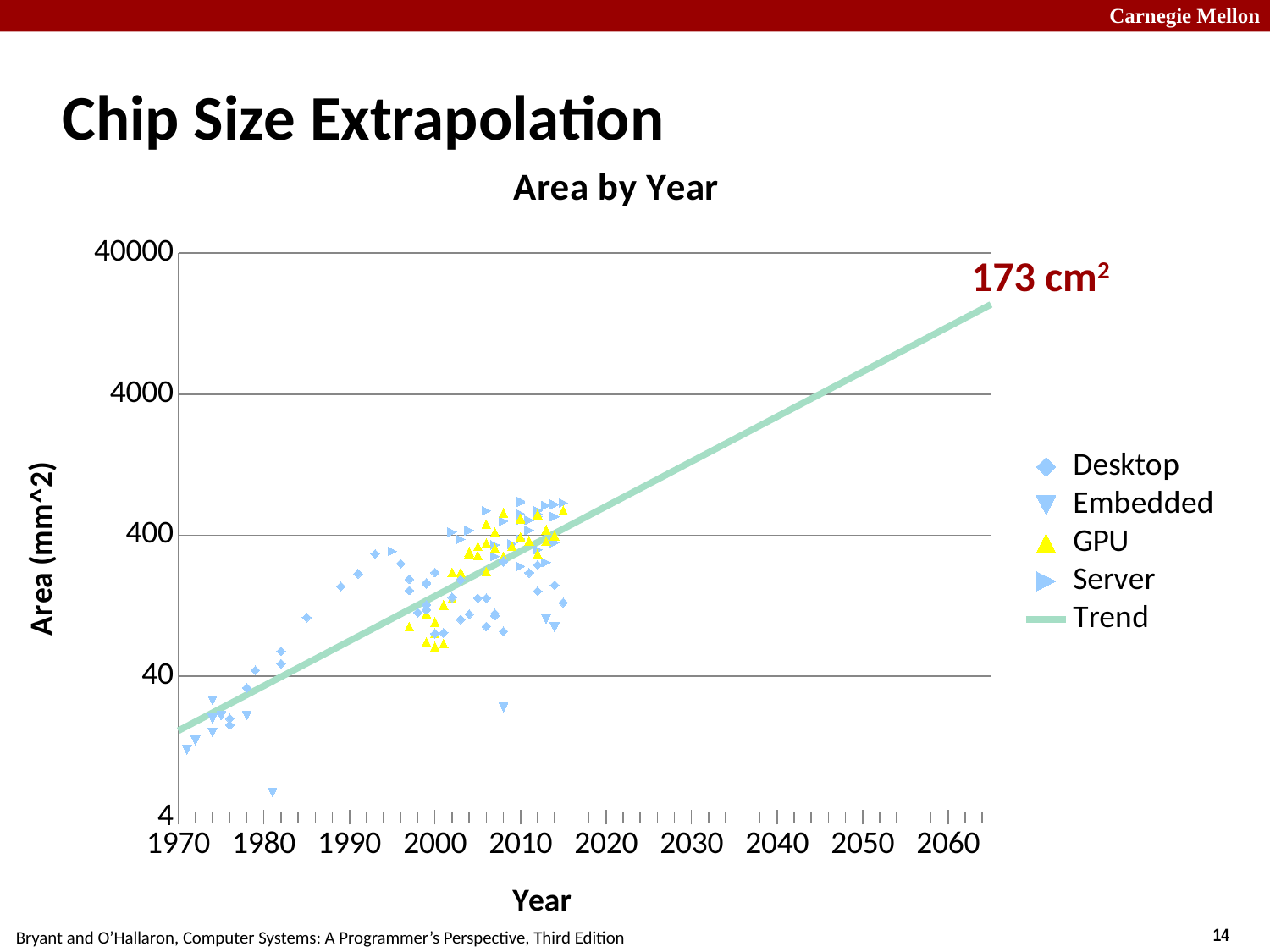
Is the value of the Trend line at 2040 greater or less than 400? greater What is the label of the y axis? Area (mm^2) What is the title of the chart? Area by Year Does the Trend line rise or fall as the year increases? rises What is the first year shown on the x axis? 1970 What chip area does the annotation at the end of the trend line give? 173 cm² Is the value of the Trend line at 2060 greater or less than 4000? greater How many series does the legend list? 5 Is the lowest Embedded point, near 1981, greater or less than 40? less What kind of chart is shown on the slide? scatter chart